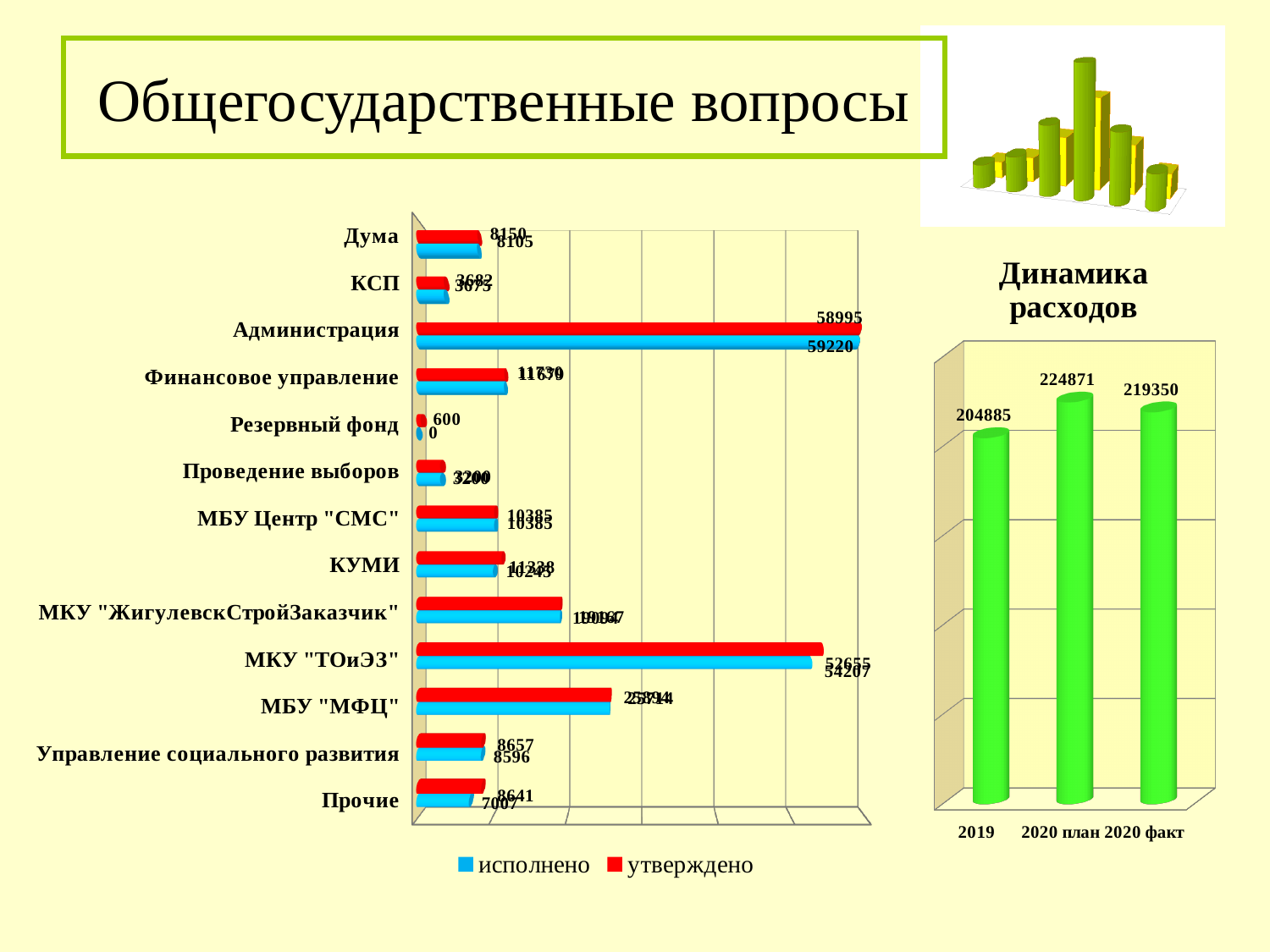
In the 'Динамика расходов' chart, what is the value for 2019? 204885 In the 'Динамика расходов' chart, what is the difference between 2020 план and 2020 факт? 5521 How many series does the legend of the left bar chart list? 2 In the left bar chart, which is larger for МКУ "ТОиЭЗ": 'исполнено' or 'утверждено'? утверждено In the left bar chart, what is the 'исполнено' value for Резервный фонд? 0 In the left bar chart, what is the 'утверждено' value for Администрация? 59220 How many categories are shown in the left bar chart? 13 In the left bar chart, what is the 'исполнено' value for Администрация? 58995 In the left bar chart, what is the difference between 'утверждено' and 'исполнено' for Прочие? 1634 In the 'Динамика расходов' chart, what is the value for 2020 план? 224871 In the left bar chart, which category has the highest 'исполнено' value? Администрация In the 'Динамика расходов' chart, which year/category has the highest value? 2020 план